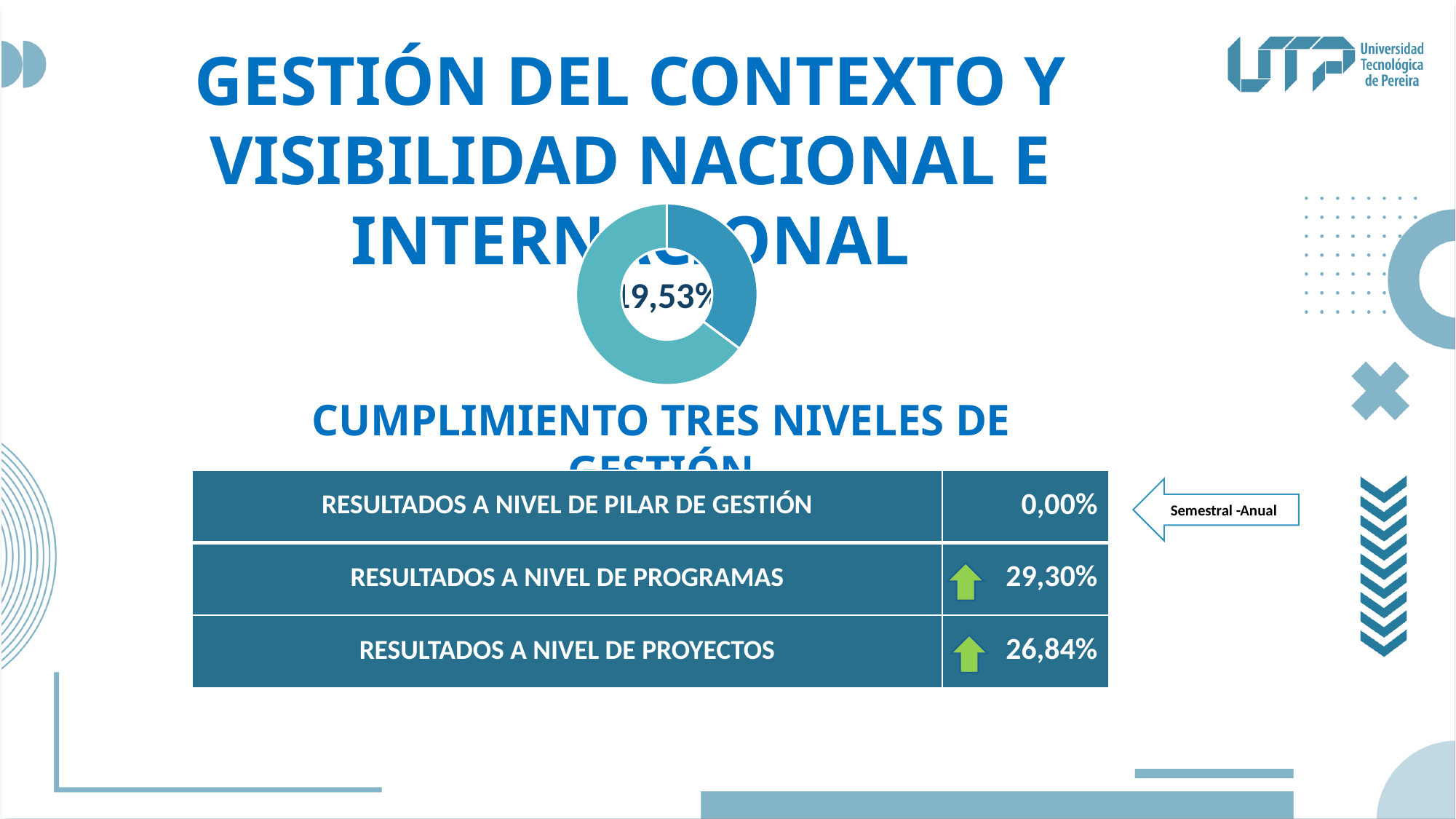
How many slices does the doughnut chart have? 2 Is the dark blue slice of the doughnut chart greater or less than 50% of the whole? less What kind of chart is shown in the middle of the slide? Doughnut (pie) chart What percentage value is printed in the centre of the doughnut chart? 19,53% Which slice of the doughnut chart is larger, the dark blue one or the light teal one? The light teal one Does the doughnut chart display a legend? No